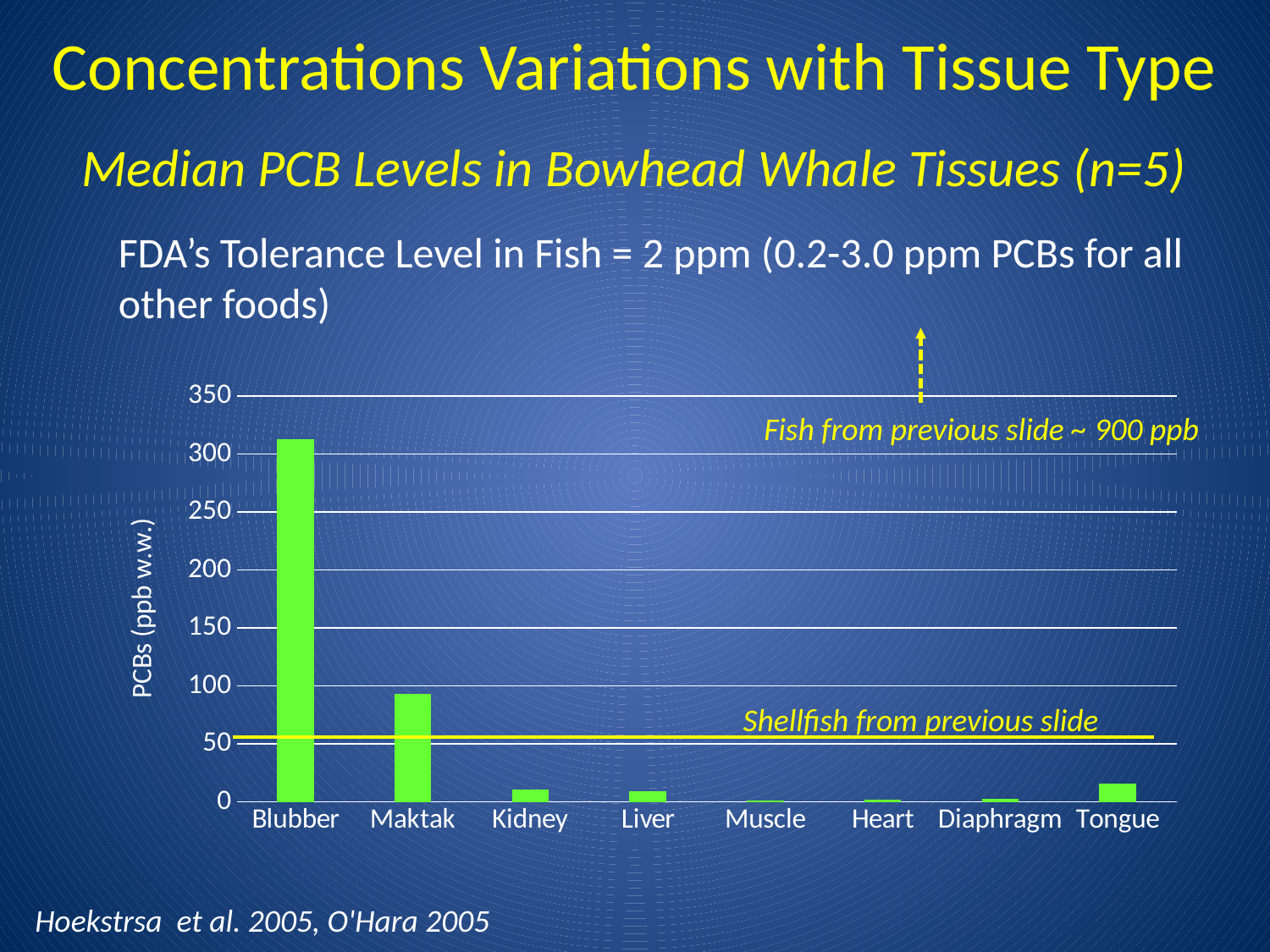
What is the title of the chart? Median PCB Levels in Bowhead Whale Tissues (n=5) What kind of chart is shown on the slide? Bar chart Is the value for Tongue greater or less than 50? less Which has a higher median PCB level, Tongue or Muscle? Tongue Is the value for Maktak greater or less than 50? greater Is the value for Maktak greater or less than 100? less How many tissue types are plotted on the x axis of the chart? 8 Which tissue type has the highest median PCB level in the chart? Blubber What is the label on the y axis of the chart? PCBs (ppb w.w.) Which has a higher median PCB level, Maktak or Kidney? Maktak Which has a higher median PCB level, Blubber or Maktak? Blubber